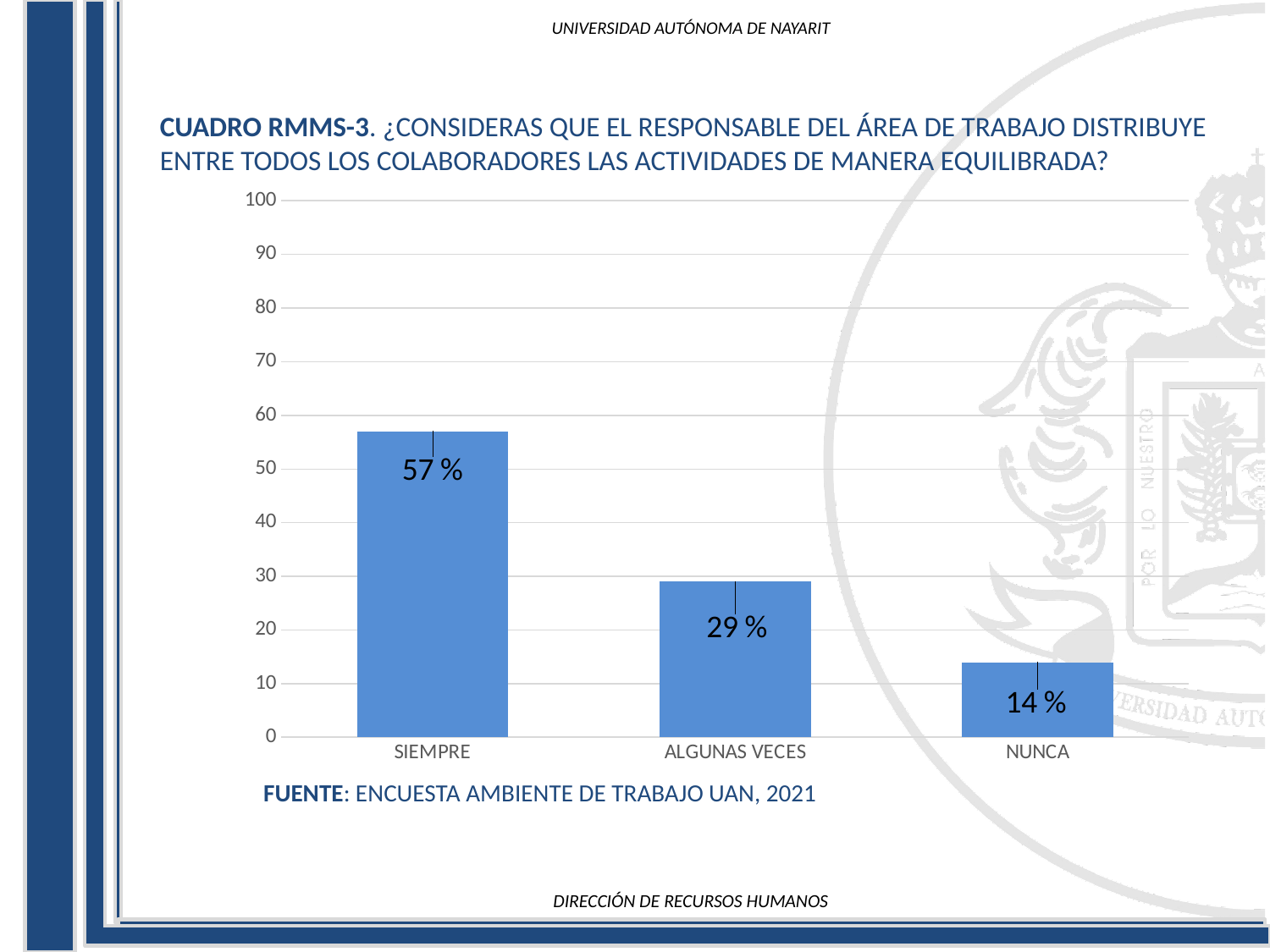
What kind of chart is shown on the slide? bar chart What is the value for ALGUNAS VECES? 29 % Which is larger, the value for ALGUNAS VECES or the value for NUNCA? ALGUNAS VECES What is the difference between the values for SIEMPRE and ALGUNAS VECES? 28 % What is the value for SIEMPRE? 57 % Is the value for SIEMPRE greater or less than 50? greater Which category has the highest value? SIEMPRE Do the values rise or fall from left to right along the x axis? fall What is the difference between the values for ALGUNAS VECES and NUNCA? 15 % What is the value for NUNCA? 14 % Which category has the lowest value? NUNCA How many categories are shown on the x axis? 3